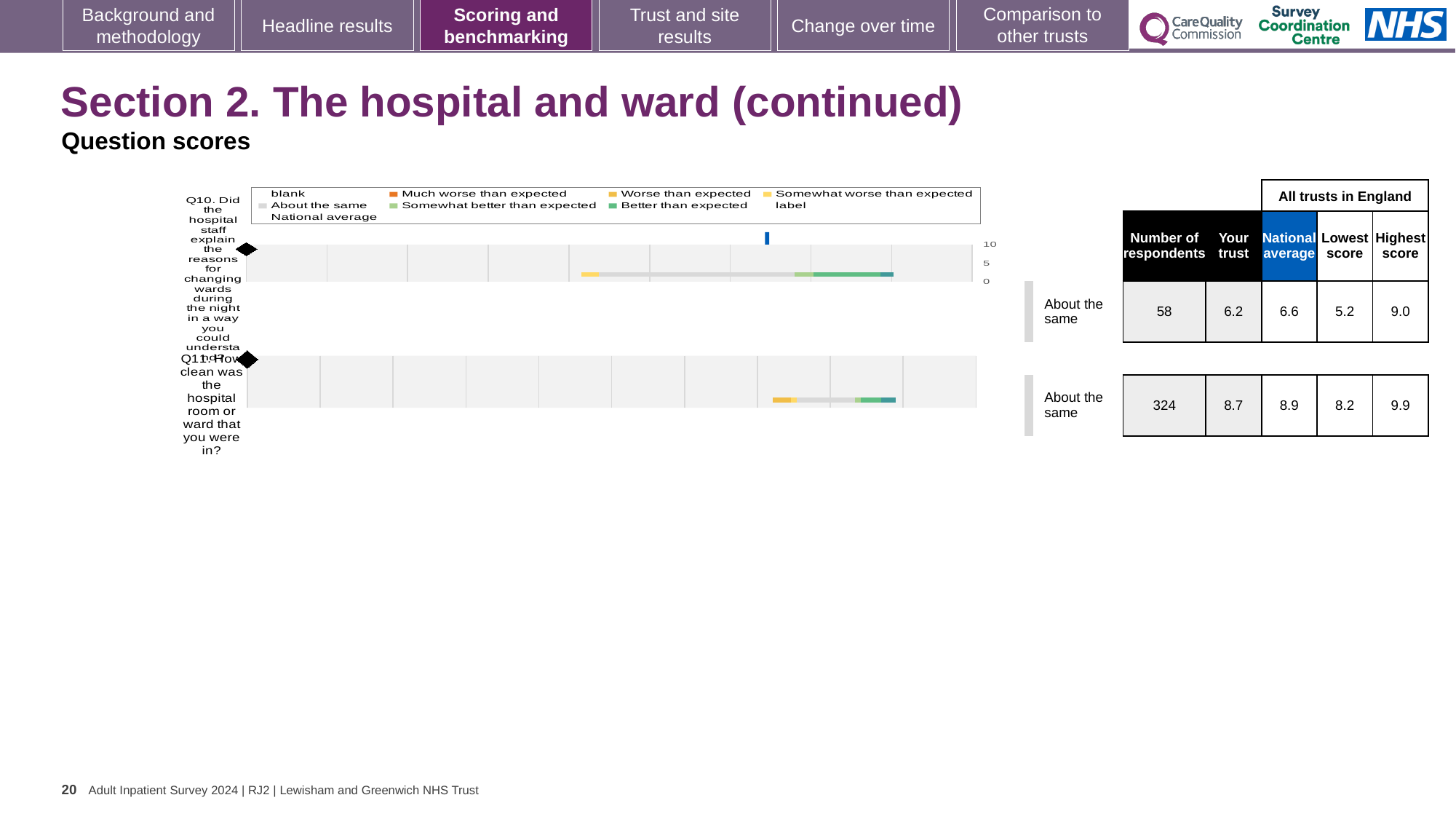
What benchmark category is the trust placed in for Q11? About the same What is the difference between the highest score and the lowest score across all trusts in England for Q11? 1.7 What is the difference between the national average and the trust score for Q10? 0.4 How many entries does the legend of the question scores chart list? 9 How many survey questions are plotted in the question scores chart? 2 What kind of chart is used to show the question scores for Q10 and Q11? bar chart Which question has the higher 'Your trust' score, Q10 or Q11? Q11 What is the 'Your trust' score for Q10 (Did the hospital staff explain the reasons for changing wards during the night)? 6.2 How many respondents answered Q10? 58 In the question scores chart legend, which category is shown in orange? Much worse than expected What is the 'Your trust' score for Q11 (How clean was the hospital room or ward that you were in?)? 8.7 What is the national average score for Q11? 8.9